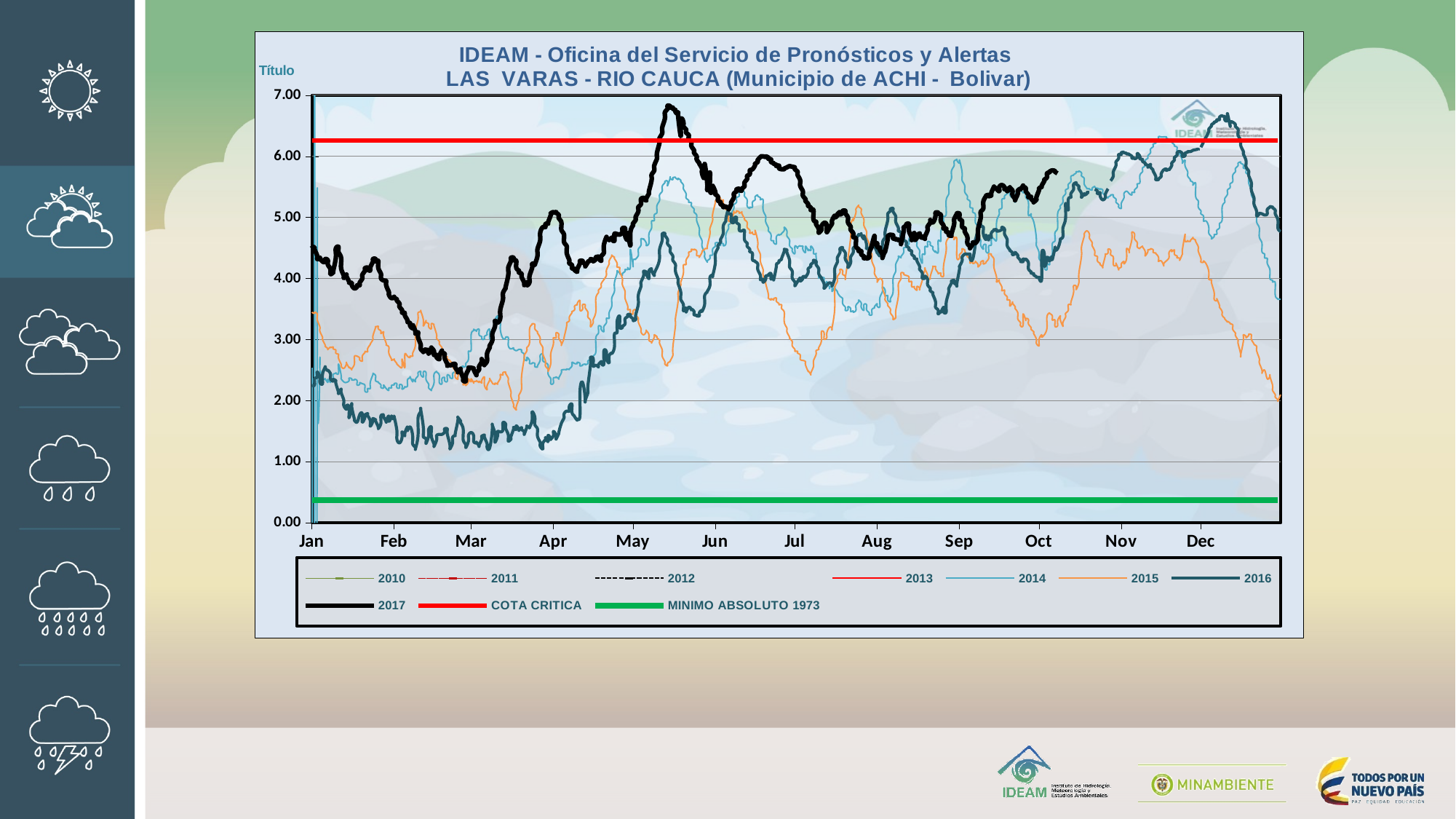
Which year series reaches the highest value in May? 2017 How many months are labelled along the x axis? 12 How many series does the legend list? 10 Is the COTA CRITICA line greater or less than 6.00? greater What kind of chart is shown on the slide? line chart Does the 2017 series rise or fall from January to March? fall Is the peak of the 2017 series in May greater or less than 6.00? greater Is the value of the 2016 series in February greater or less than 2.00? less Which is higher, the COTA CRITICA line or the MINIMO ABSOLUTO 1973 line? COTA CRITICA What colour is the COTA CRITICA line? red Which year series has the lowest values in February? 2016